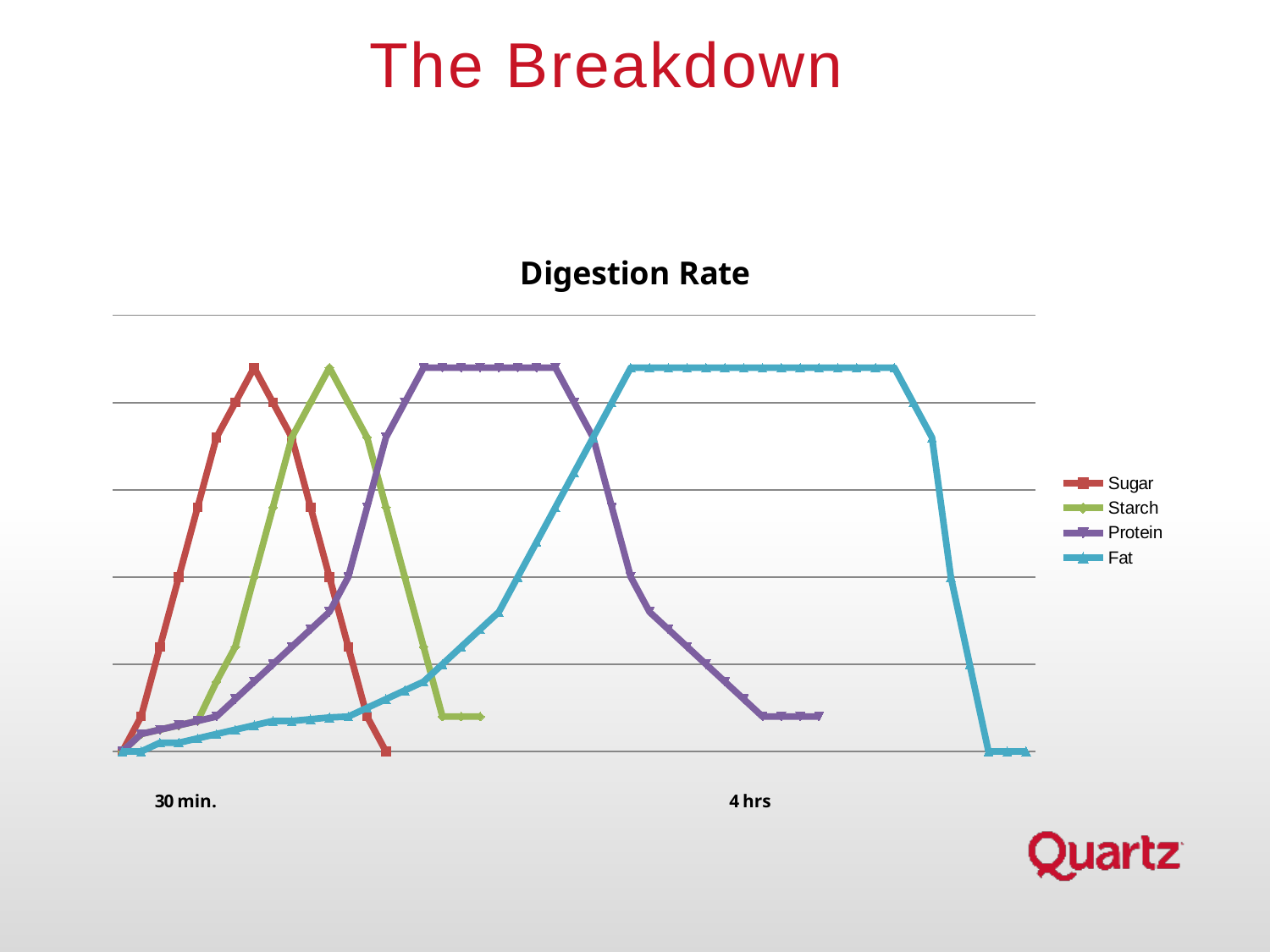
How many time labels are shown on the x axis? 2 Which series peaks later, Sugar or Fat? Fat Which series is drawn in red? Sugar What is the title of the chart? Digestion Rate Which series reaches its peak earliest along the x axis? Sugar What kind of chart is shown on the slide? Line chart Which series is the last to return to the baseline along the x axis? Fat How many series does the legend list? 4 Does the Sugar line rise or fall after its peak? Fall